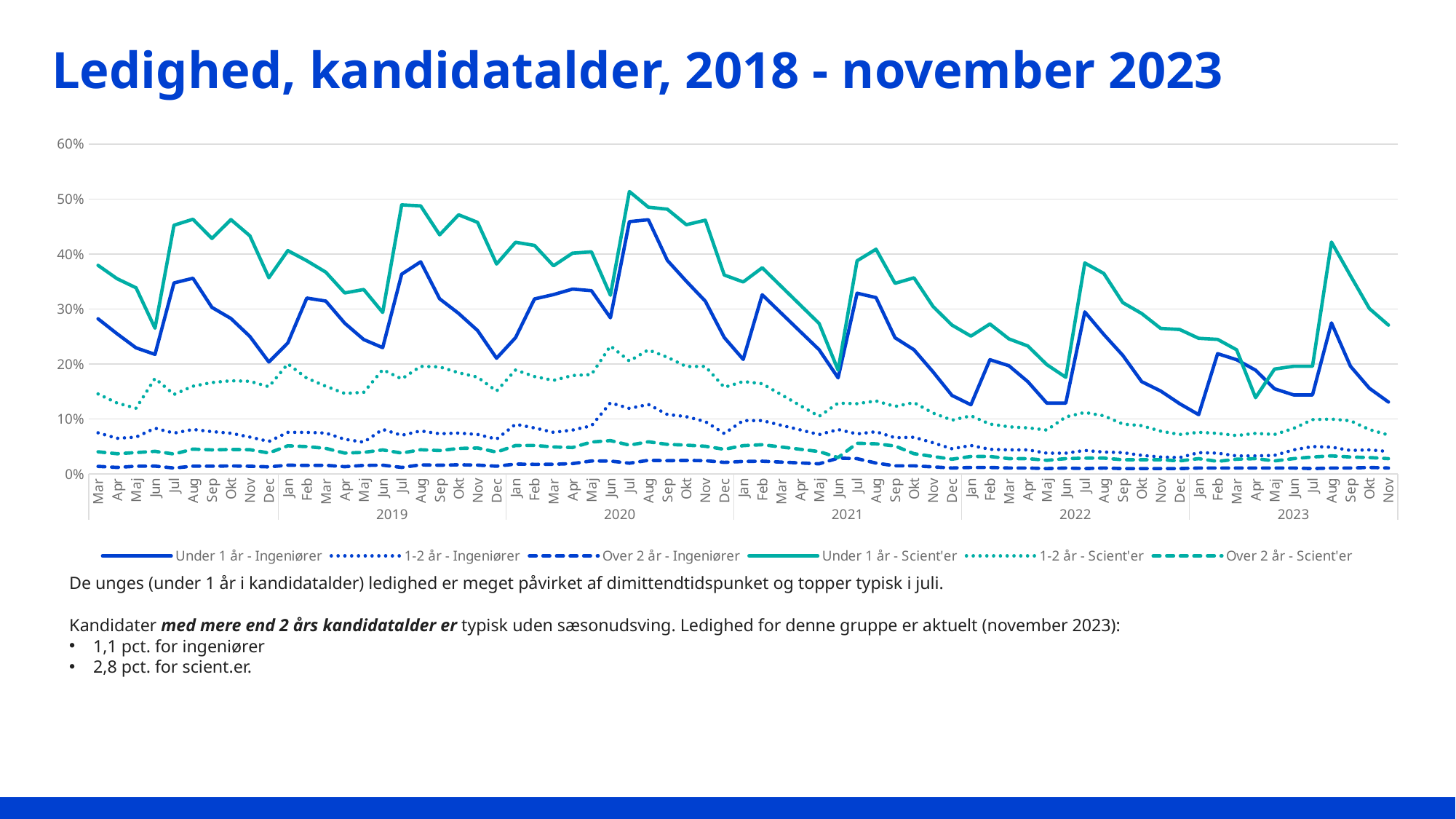
According to the slide text, what is the unemployment rate in November 2023 for ingeniører with more than 2 years since graduation? 1,1 pct. Is the value for 'Under 1 år - Ingeniører' in Jul 2020 greater or less than 40%? greater Does the 'Under 1 år - Scient'er' line rise or fall from Aug 2023 to Nov 2023? fall How many series does the chart's legend list? 6 What is the title of the slide's chart? Ledighed, kandidatalder, 2018 - november 2023 What kind of chart is shown on the slide? line chart Which series has the highest value in Jul 2020? Under 1 år - Scient'er Which series has the lowest value in Nov 2023? Over 2 år - Ingeniører In Aug 2023, which is larger: 'Under 1 år - Scient'er' or 'Under 1 år - Ingeniører'? Under 1 år - Scient'er Is the value for 'Over 2 år - Scient'er' in Nov 2023 greater or less than 10%? less Is the value for 'Under 1 år - Scient'er' in Jul 2020 greater or less than 40%? greater